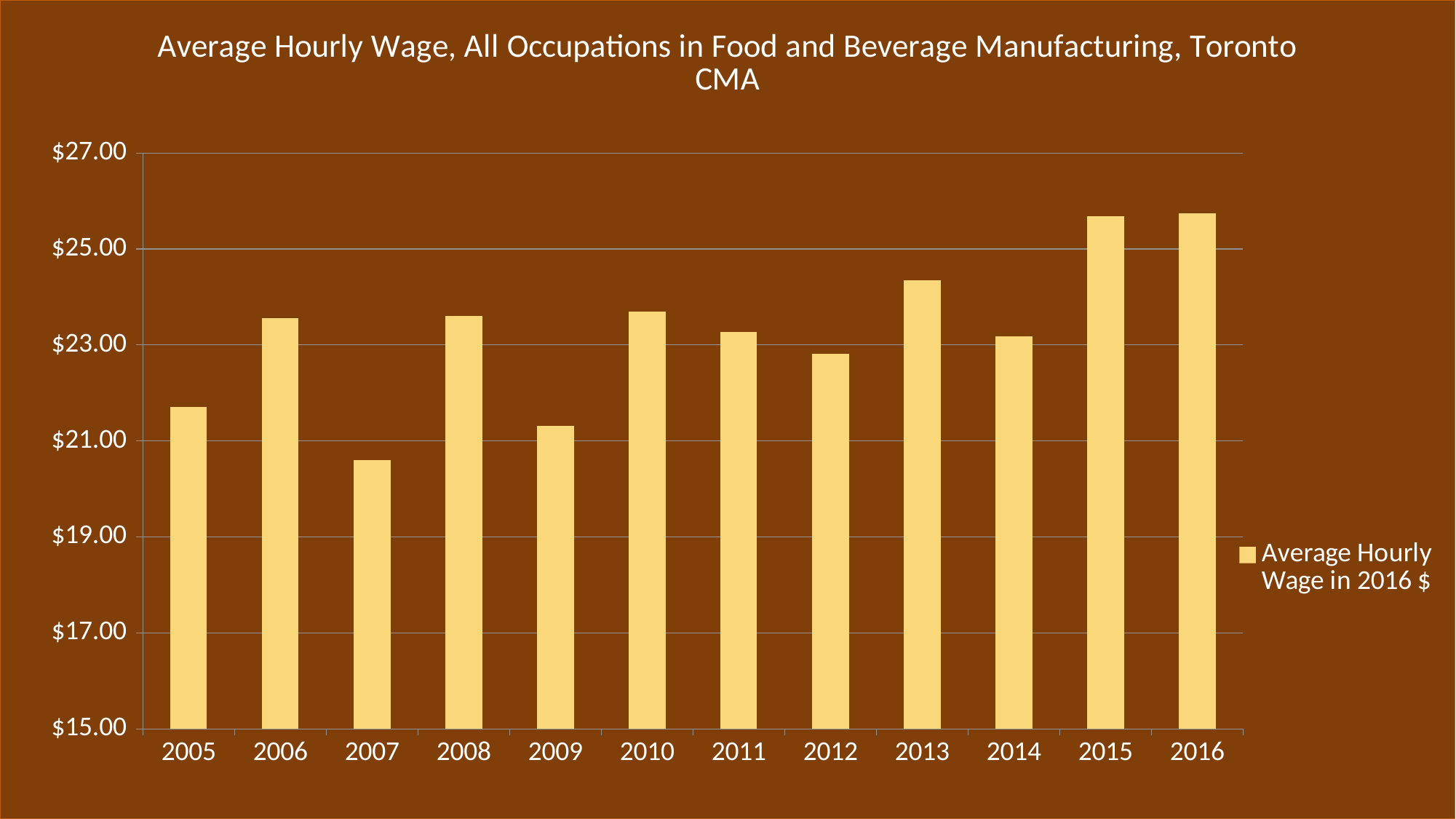
Is the value for 2007 greater or less than $21.00? less Is the value for 2005 greater or less than $21.00? greater Which is larger, the value for 2013 or the value for 2014? 2013 What is the legend entry for the series in the chart? Average Hourly Wage in 2016 $ What kind of chart is shown on the slide? bar chart Is the value for 2013 greater or less than $23.00? greater How many years are shown on the x axis of the chart? 12 Which year has the lowest average hourly wage? 2007 Which is larger, the value for 2005 or the value for 2007? 2005 How many series does the legend list? 1